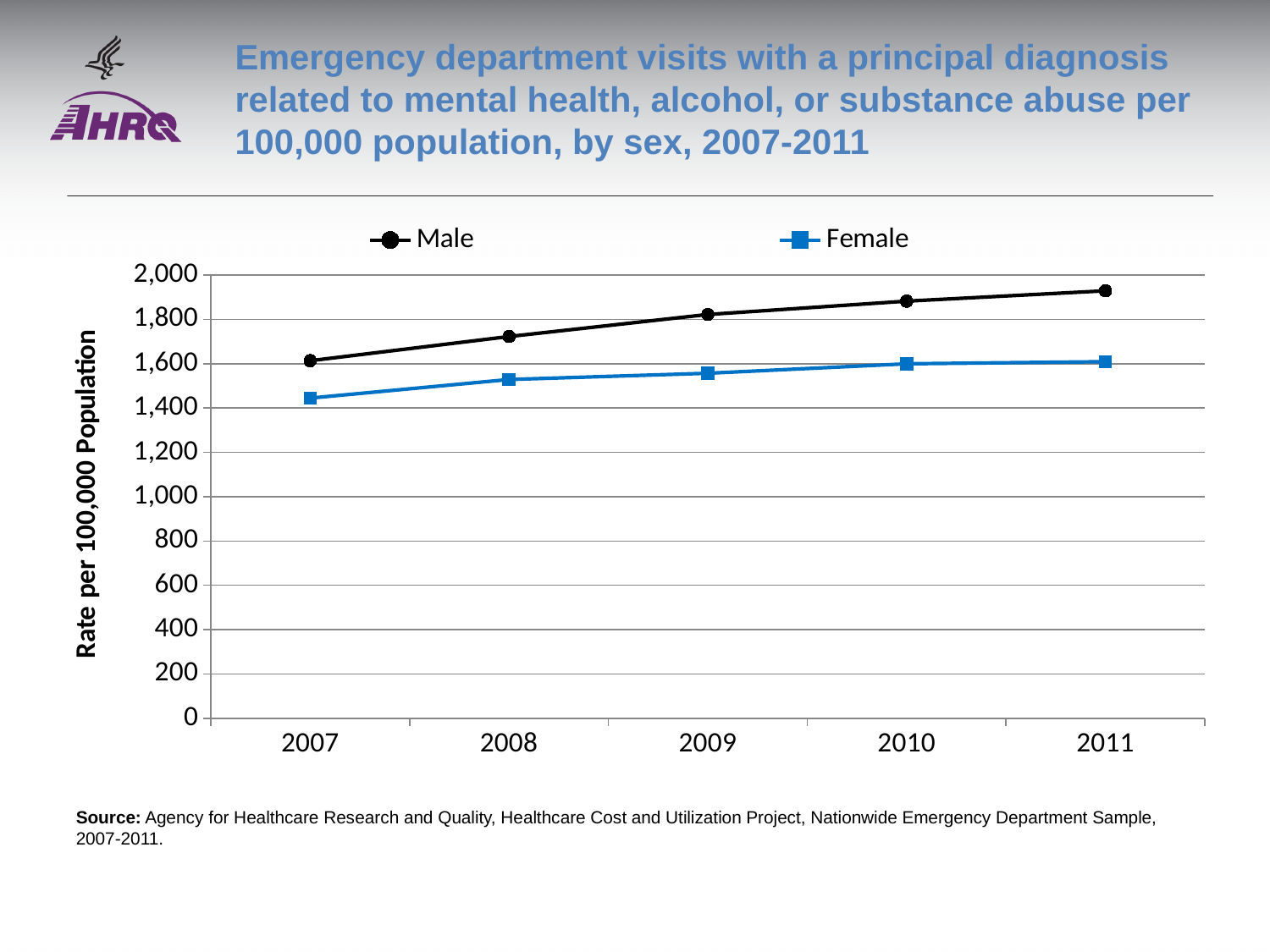
In which year is the Female rate lowest? 2007 How many series does the legend list? 2 How many years are plotted along the x axis? 5 What kind of chart is shown on the slide? Line chart Is the Male value for 2011 greater or less than 2,000? less Which two series are shown in the legend? Male and Female In 2009, which series has the higher rate, Male or Female? Male Is the Female value for 2007 greater or less than 1,400? greater What is the label of the y axis? Rate per 100,000 Population In which year is the Male rate highest? 2011 Does the Male rate rise or fall from 2007 to 2011? Rise Is the Male value for 2010 greater or less than 1,800? greater